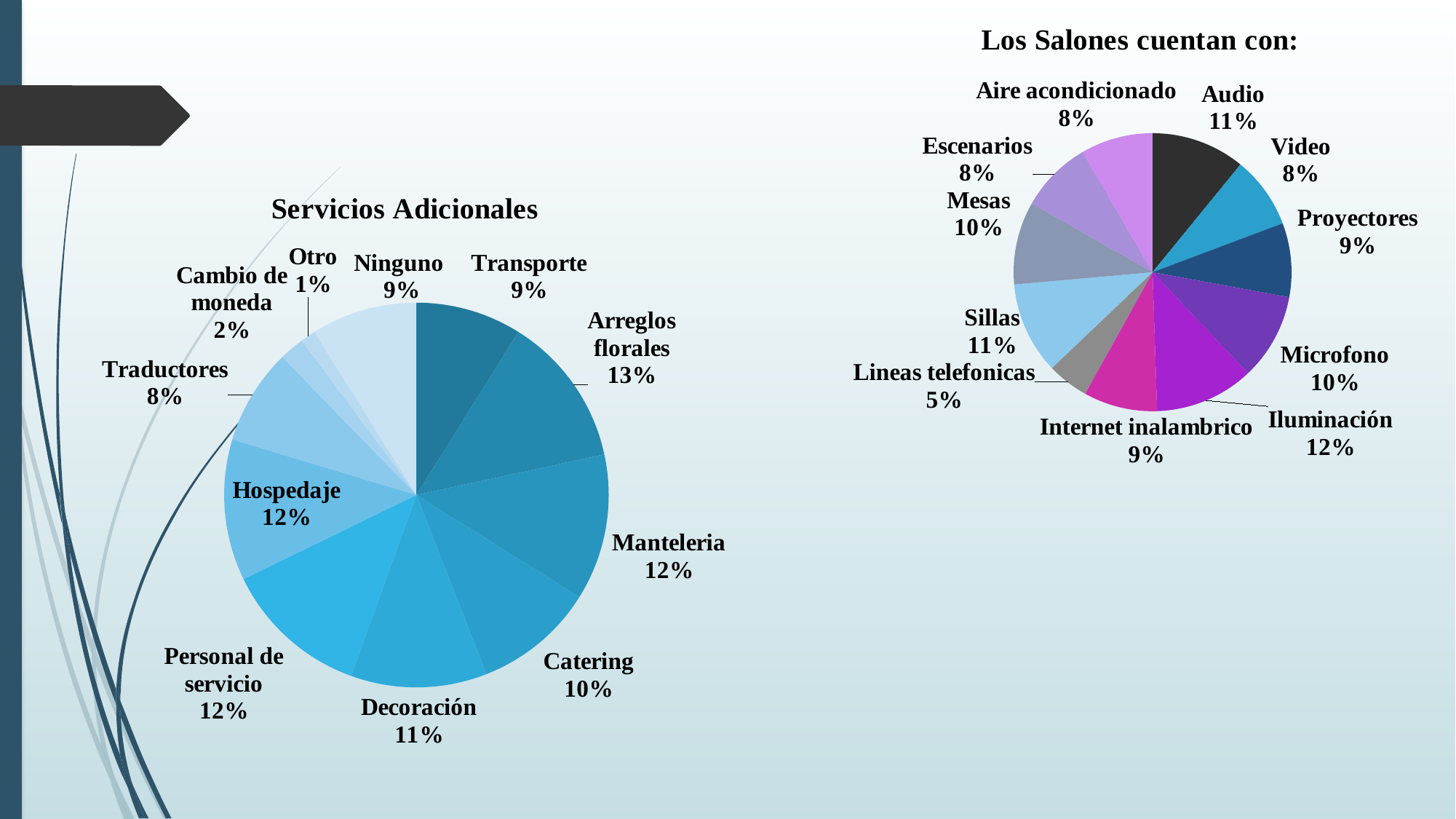
In the 'Servicios Adicionales' chart, how many categories are shown? 11 In the 'Servicios Adicionales' chart, what share does Arreglos florales have? 13% In the 'Servicios Adicionales' chart, which category has the smallest share? Otro In the 'Los Salones cuentan con:' chart, what is the difference between the shares of Sillas and Mesas? 1% In the 'Los Salones cuentan con:' chart, which category has the smallest share? Lineas telefonicas In the 'Servicios Adicionales' chart, what is the difference between the shares of Hospedaje and Traductores? 4% What type of chart is 'Servicios Adicionales'? Pie chart In the 'Los Salones cuentan con:' chart, which is larger, Audio or Video? Audio In the 'Servicios Adicionales' chart, which category has the largest share? Arreglos florales In the 'Los Salones cuentan con:' chart, which category has the largest share? Iluminación In the 'Los Salones cuentan con:' chart, what share does Lineas telefonicas have? 5% What is the title of the chart on the right side of the slide? Los Salones cuentan con: